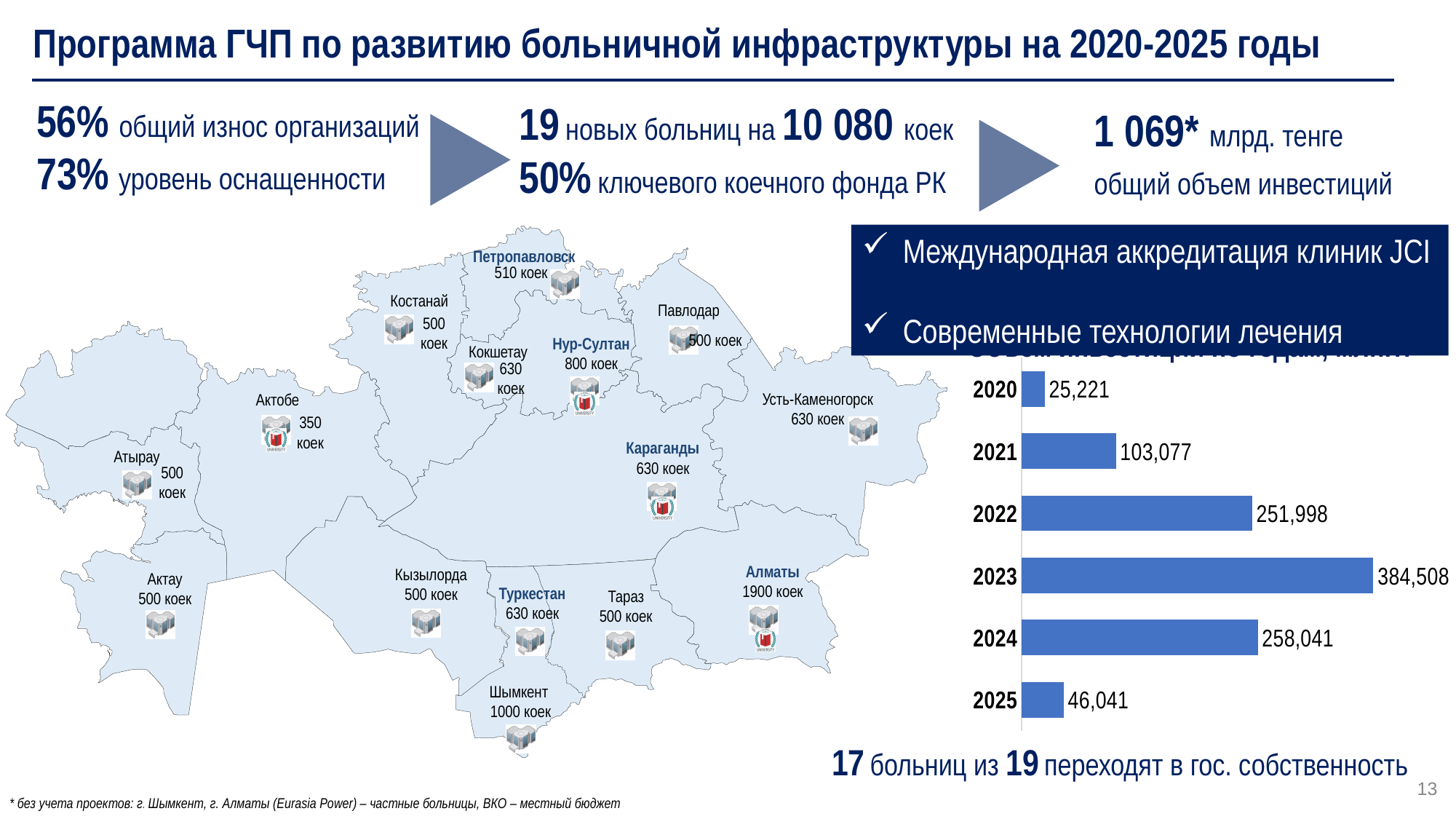
What is the value for 2020 in the bar chart? 25,221 Which year has the lowest value in the bar chart? 2020 What is the difference between the values for 2024 and 2022 in the bar chart? 6,043 What kind of chart is shown on the right side of the slide? bar chart What is the value for 2023 in the bar chart? 384,508 Which is larger in the bar chart, the value for 2021 or the value for 2025? 2021 What is the difference between the values for 2023 and 2020 in the bar chart? 359,287 How many years are shown in the bar chart? 6 Do the values in the bar chart rise or fall from 2020 to 2023? rise Which year has the highest value in the bar chart? 2023 What is the value for 2025 in the bar chart? 46,041 What is the value for 2021 in the bar chart? 103,077